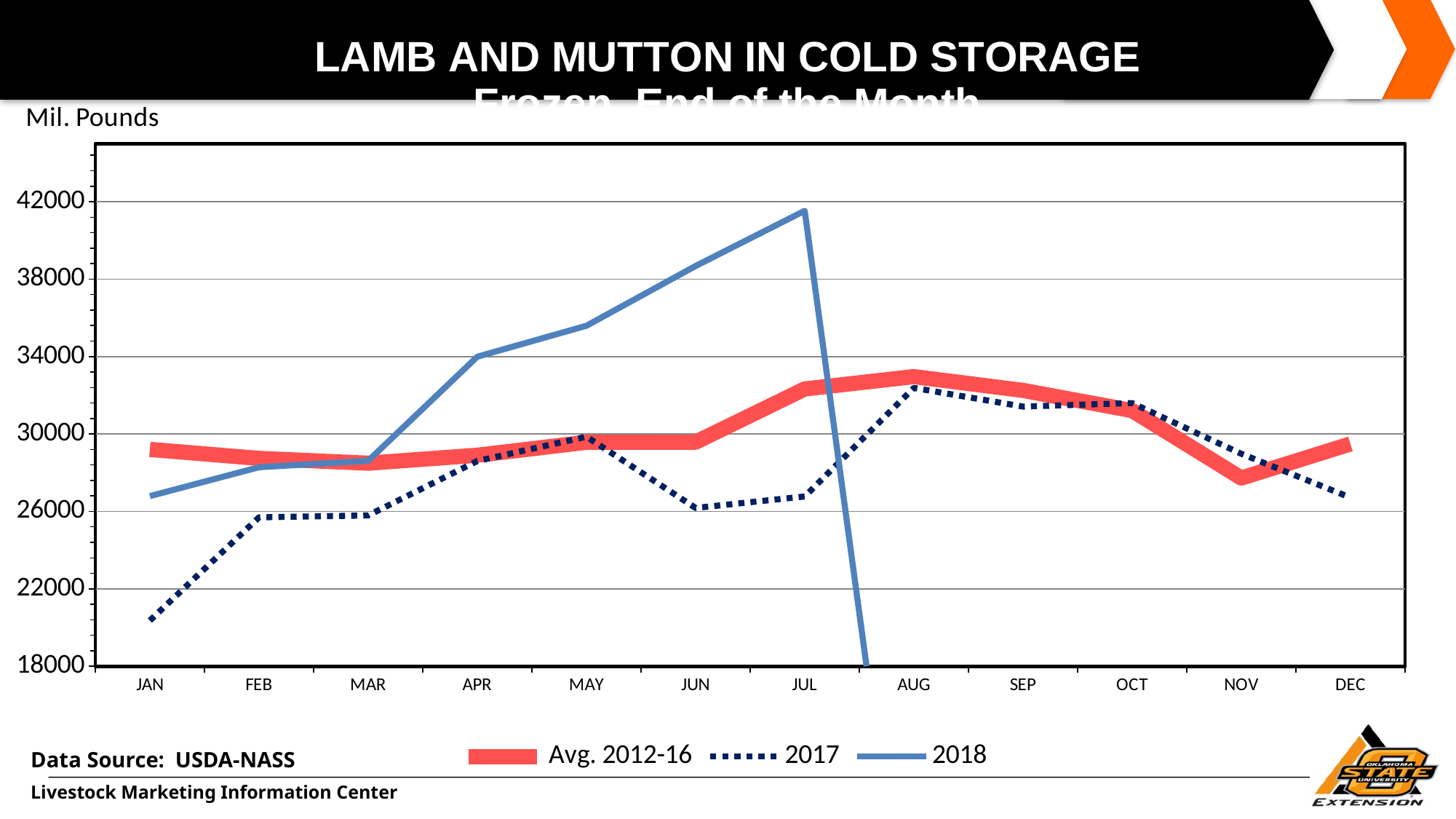
How many months are shown along the x axis? 12 Is the 2017 value for JAN greater or less than 22000? less Does the 2018 line rise or fall from JAN to JUL? rise Which is larger in JAN, the 2018 value or the 2017 value? 2018 In which month does the 2018 line reach its highest value? JUL In which month is the 2017 line at its lowest value? JAN Is the 2017 value for JUN greater or less than 30000? less Which is larger in MAY, the 2018 value or the Avg. 2012-16 value? 2018 What unit label is shown above the y axis? Mil. Pounds How many series does the legend list? 3 What kind of chart is shown on the slide? Line chart Is the 2018 value for JUL greater or less than 38000? greater